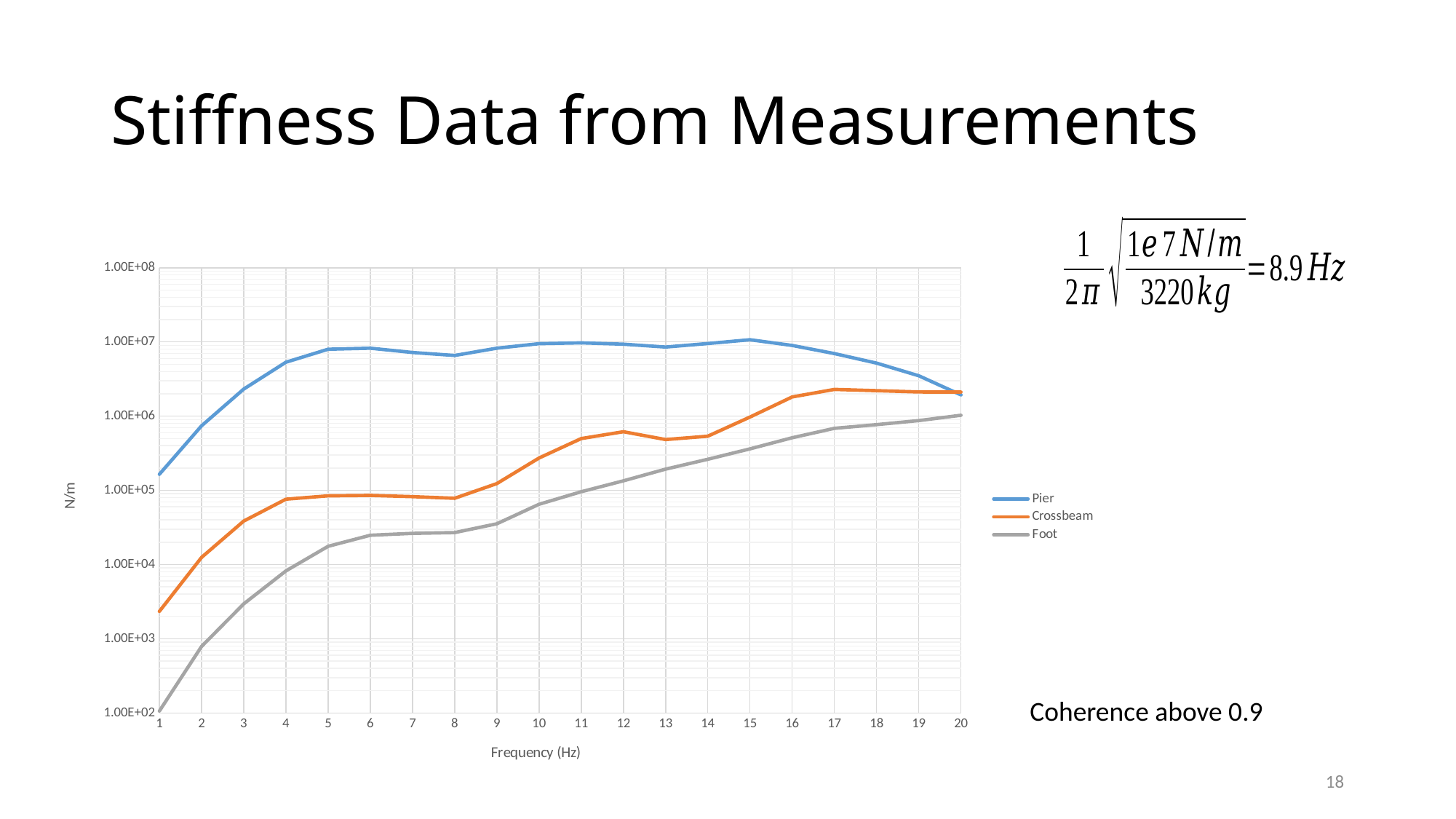
Is the value for Crossbeam at 1 Hz greater or less than 1.00E+04? less Does the Foot series generally rise or fall as frequency increases from 1 Hz to 20 Hz? Rise How many frequency points are plotted along the x axis? 20 How many series does the legend list? 3 Is the value for Foot at 10 Hz greater or less than 1.00E+05? less Which series has the lowest stiffness at 1 Hz? Foot Which series has the highest stiffness at 10 Hz? Pier Is the value for Crossbeam at 17 Hz greater or less than 1.00E+06? greater At 5 Hz, which is larger: the Crossbeam value or the Foot value? Crossbeam What is the label of the x axis? Frequency (Hz) What kind of chart is shown on the slide? Line chart